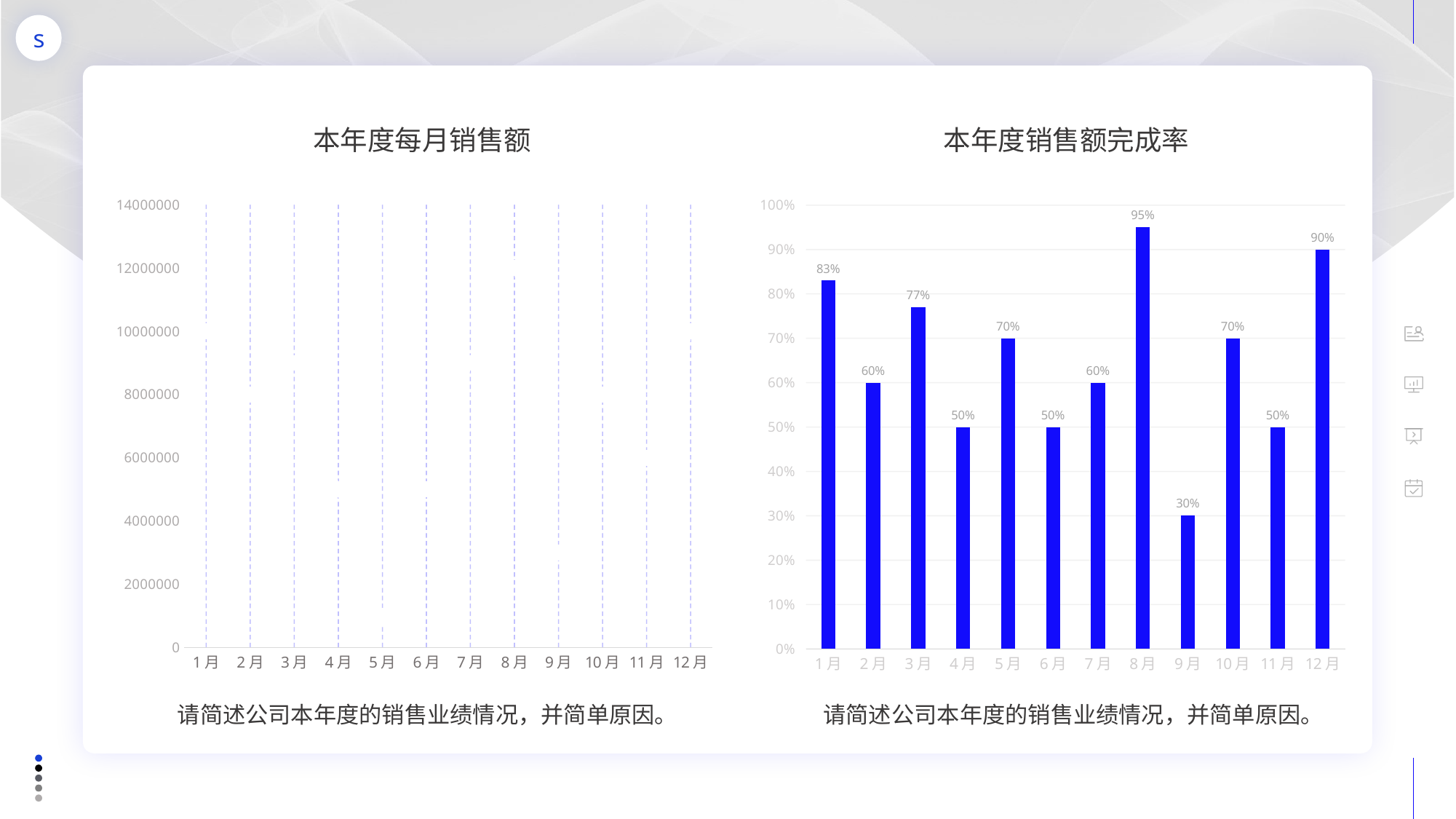
What kind of chart is the chart titled 本年度销售额完成率? bar chart In the chart titled 本年度销售额完成率, which month has the lowest completion rate? 9月 What is the title of the chart on the left side of the slide? 本年度每月销售额 In the chart titled 本年度销售额完成率, which is larger, the value for 1月 or the value for 3月? 1月 How many months are shown on the x axis of the chart titled 本年度销售额完成率? 12 In the chart titled 本年度销售额完成率, does the value rise or fall from 8月 to 9月? fall In the chart titled 本年度销售额完成率, what is the value for 1月? 83% In the chart titled 本年度销售额完成率, what is the value for 9月? 30% In the chart titled 本年度销售额完成率, what is the value for 12月? 90% In the chart titled 本年度销售额完成率, is the value for 5月 greater or less than 60%? greater In the chart titled 本年度销售额完成率, what is the difference between the values for 8月 and 9月? 65% In the chart titled 本年度销售额完成率, which month has the highest completion rate? 8月